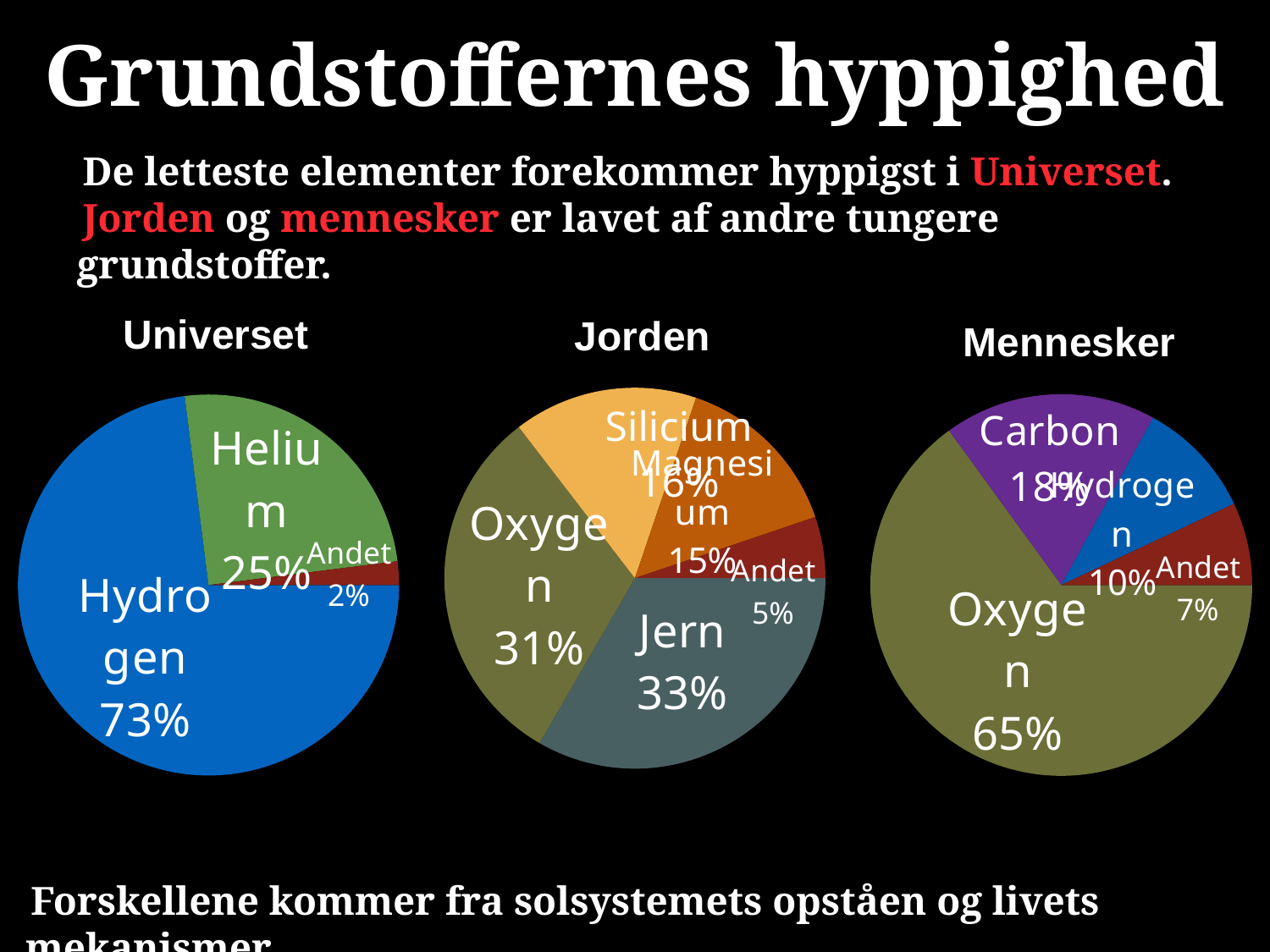
In the Jorden pie chart, what is the difference between Oxygen and Andet? 26% What kind of charts are shown on the slide? Pie charts In the Mennesker pie chart, what percentage is Oxygen? 65% In the Universet pie chart, what percentage is Helium? 25% In the Mennesker pie chart, what percentage is Andet? 7% In the Jorden pie chart, how many slices are there? 5 In the Mennesker pie chart, which is larger, Carbon or Hydrogen? Carbon In the Universet pie chart, how many slices are there? 3 In the Jorden pie chart, which slice is the largest? Jern In the Universet pie chart, which slice is the smallest? Andet In the Universet pie chart, what percentage is Hydrogen? 73% In the Jorden pie chart, what percentage is Jern? 33%